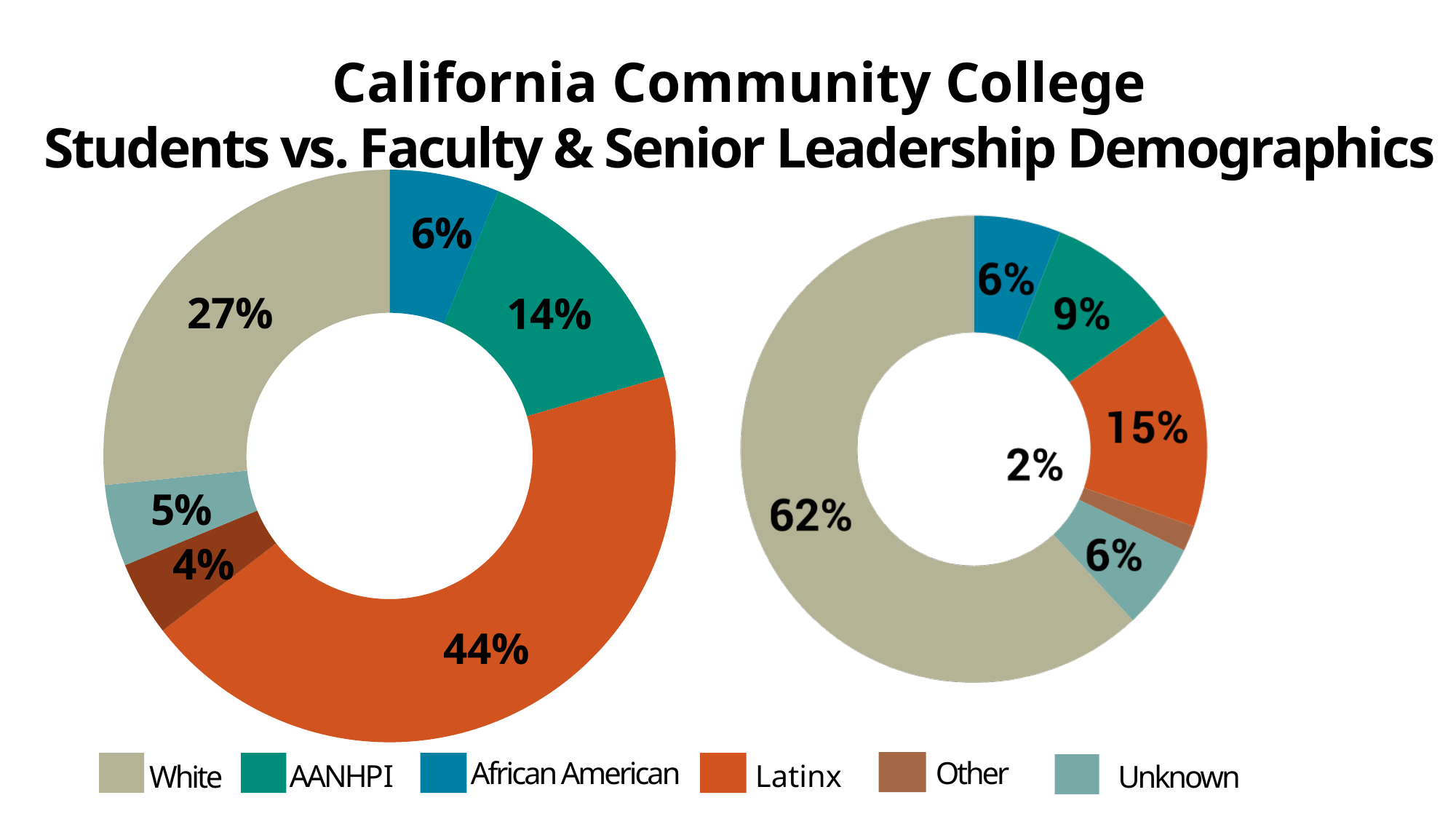
In the right donut chart, which category has the smallest share? Other In the left donut chart, what percentage is shown for AANHPI? 14% In the right donut chart, what percentage is shown for White? 62% What is the title of the slide? California Community College Students vs. Faculty & Senior Leadership Demographics How many series does the legend list? 6 In the left donut chart, what is the combined share of Other and Unknown? 9% In the left donut chart, which category has the largest share? Latinx What is the difference between the White share in the right donut chart and the White share in the left donut chart? 35% Which is larger: the Latinx share in the left donut chart or the Latinx share in the right donut chart? Left donut chart In the right donut chart, what percentage is shown for Latinx? 15% What kind of chart is used on this slide? Donut (pie) chart In the left donut chart, what percentage is shown for Latinx? 44%